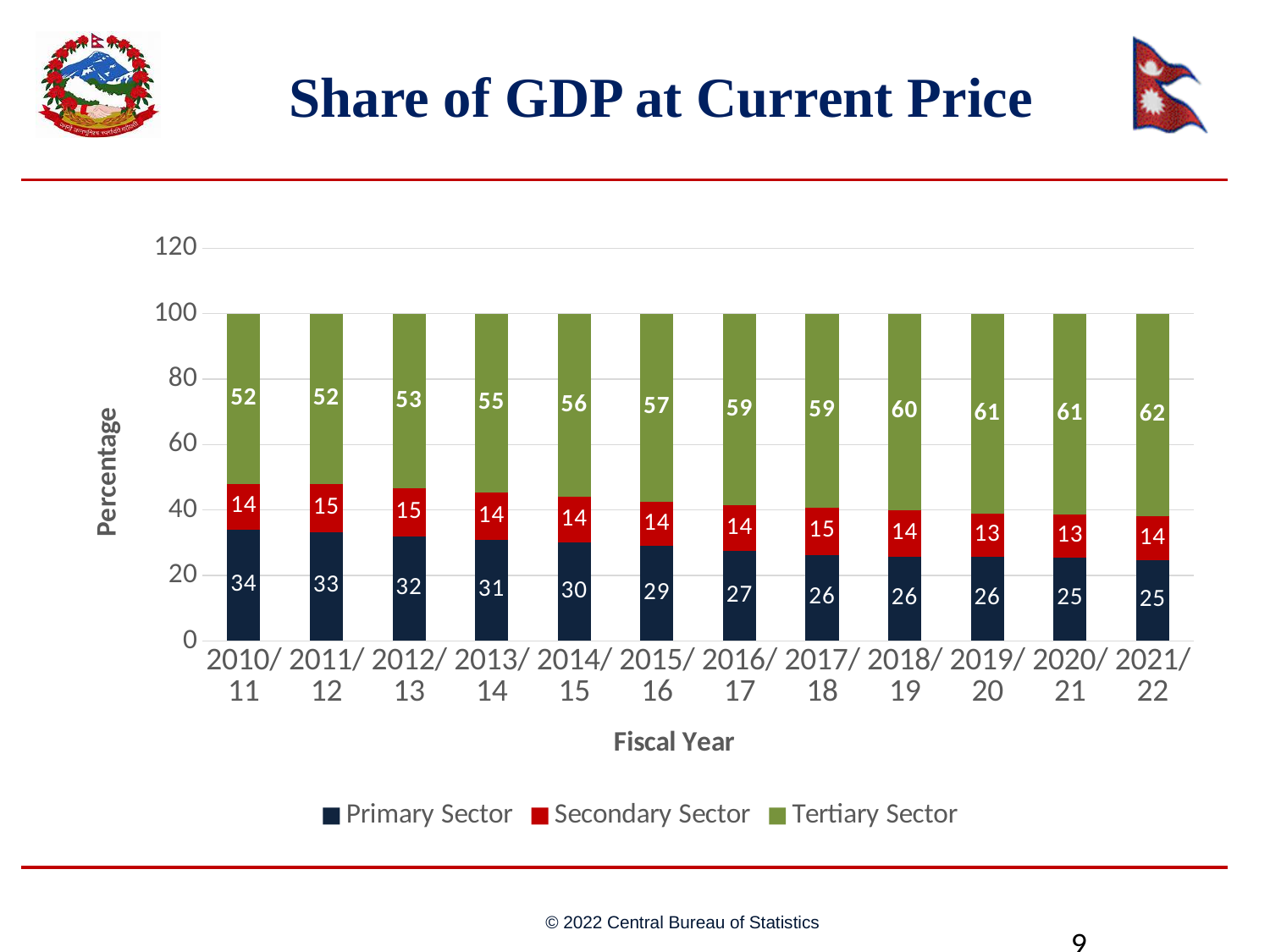
Does the Primary Sector share rise or fall from 2010/11 to 2021/22? Fall In which fiscal year is the Primary Sector share highest? 2010/11 How many series does the legend list? 3 What is the Tertiary Sector share of GDP in fiscal year 2021/22? 62 Which is larger in 2015/16: the Primary Sector share or the Secondary Sector share? Primary Sector In which fiscal year is the Tertiary Sector share highest? 2021/22 How many fiscal years are shown on the x axis? 12 What is the total of the stacked bar for fiscal year 2010/11? 100 What is the Secondary Sector share of GDP in fiscal year 2017/18? 15 What kind of chart is shown on the slide? Stacked bar chart What is the difference between the Tertiary Sector share in 2021/22 and in 2010/11? 10 What is the Primary Sector share of GDP in fiscal year 2010/11? 34